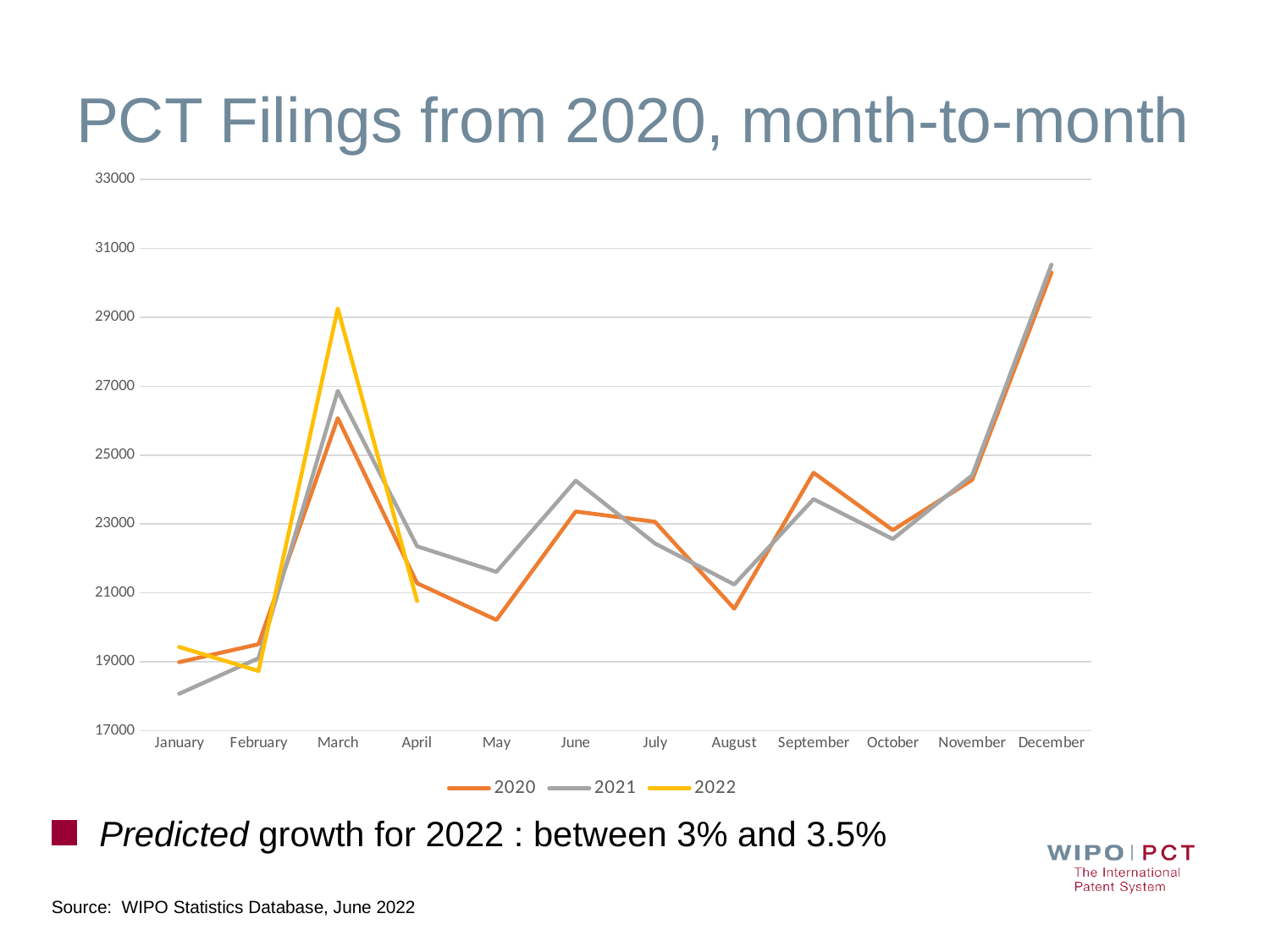
In March, which series has the higher value, 2020 or 2021? 2021 In which month does the 2020 series reach its highest value? December Is the value for 2021 in January greater or less than 19000? less Is the value for 2022 in March greater or less than 27000? greater How many series does the legend list? 3 How many months are shown on the x axis? 12 In which month does the 2021 series have its lowest value? January Is the value for 2020 in December greater or less than 29000? greater What kind of chart is shown on the slide? line chart In September, which series has the higher value, 2020 or 2021? 2020 In which month does the 2022 series reach its highest value? March Does the 2020 series rise or fall from March to May? fall